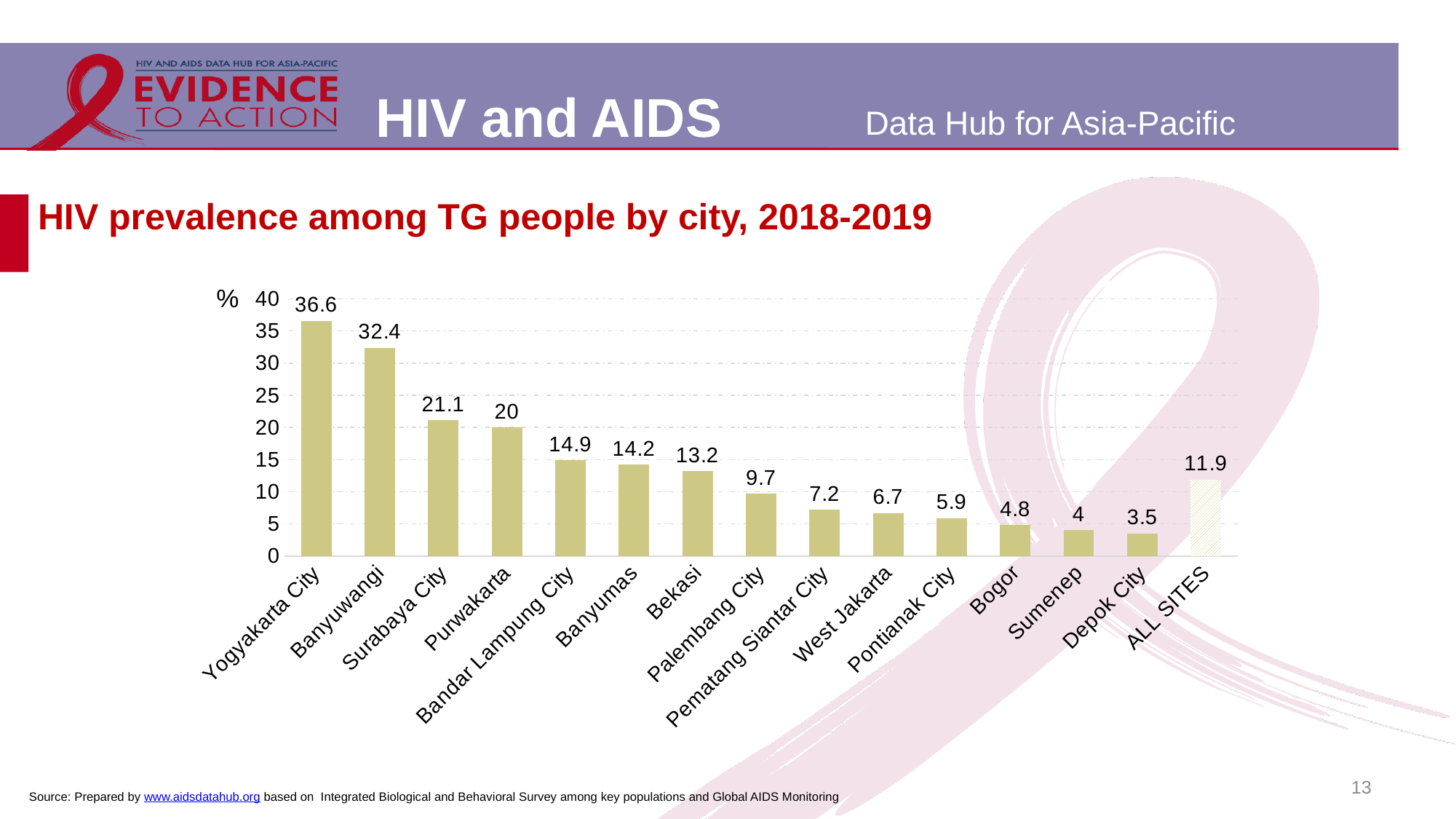
What type of chart is used on this slide? Bar chart How many bars are shown in the chart, including ALL SITES? 15 Which city has the lowest HIV prevalence among TG people? Depok City What is the HIV prevalence among TG people in Yogyakarta City? 36.6 What is the HIV prevalence among TG people in Bekasi? 13.2 What is the difference in HIV prevalence between Yogyakarta City and Banyuwangi? 4.2 Which city has the highest HIV prevalence among TG people? Yogyakarta City Which has a higher HIV prevalence, Bandar Lampung City or Banyumas? Bandar Lampung City Is the HIV prevalence for Palembang City greater or less than 10? less What is the difference in HIV prevalence between Surabaya City and Purwakarta? 1.1 What is the title of the chart on this slide? HIV prevalence among TG people by city, 2018-2019 What is the HIV prevalence value shown for ALL SITES? 11.9